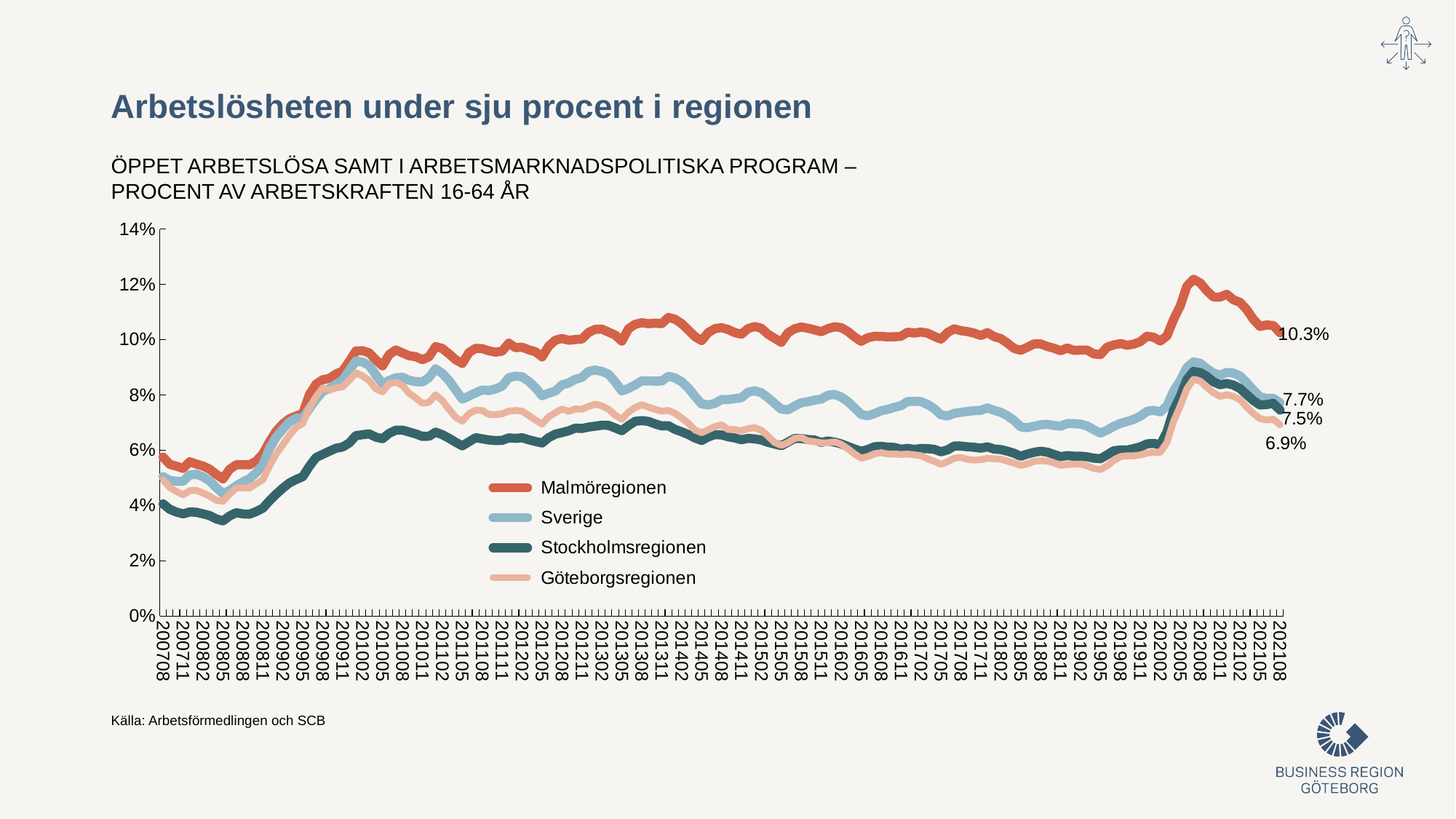
At the last point, which is larger: the Sverige value or the Stockholmsregionen value? Sverige Does the Malmöregionen line rise or fall between 202008 and 202108? Fall What kind of chart is shown on the slide? Line chart Which series has the highest value at the last point (202108)? Malmöregionen Is the value for Stockholmsregionen around 200805 greater or less than 4%? less How many series does the legend list? 4 What is the value labelled at the end of the Malmöregionen line? 10.3% Which series has the lowest value at the last point (202108)? Göteborgsregionen What is the value labelled at the end of the Stockholmsregionen line? 7.5% What is the value labelled at the end of the Göteborgsregionen line? 6.9% What is the value labelled at the end of the Sverige line? 7.7% What is the difference between the final labelled values of Malmöregionen and Göteborgsregionen? 3.4 percentage points